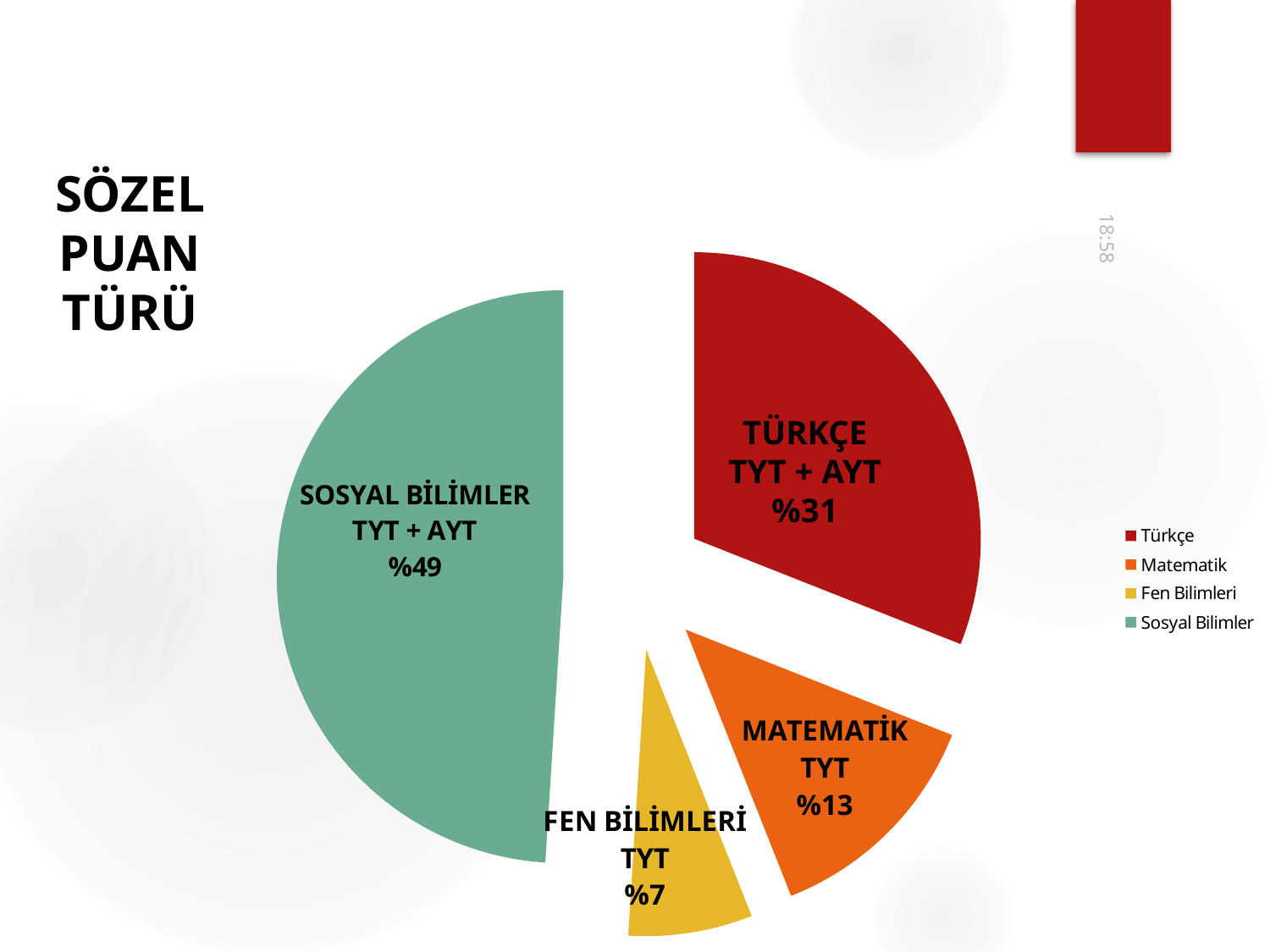
What share of the pie does Türkçe (TYT + AYT) have? %31 What colour is the Sosyal Bilimler slice? green What share of the pie does Sosyal Bilimler (TYT + AYT) have? %49 What is the difference in percentage points between the Matematik slice and the Fen Bilimleri slice? 6 Which is larger, the Türkçe slice or the Matematik slice? Türkçe Which slice of the pie is the largest? Sosyal Bilimler What share of the pie does Fen Bilimleri (TYT) have? %7 How many slices does the pie chart have? 4 What kind of chart is shown on the slide? pie chart What is the difference in percentage points between the Sosyal Bilimler slice and the Türkçe slice? 18 Which slice of the pie is the smallest? Fen Bilimleri